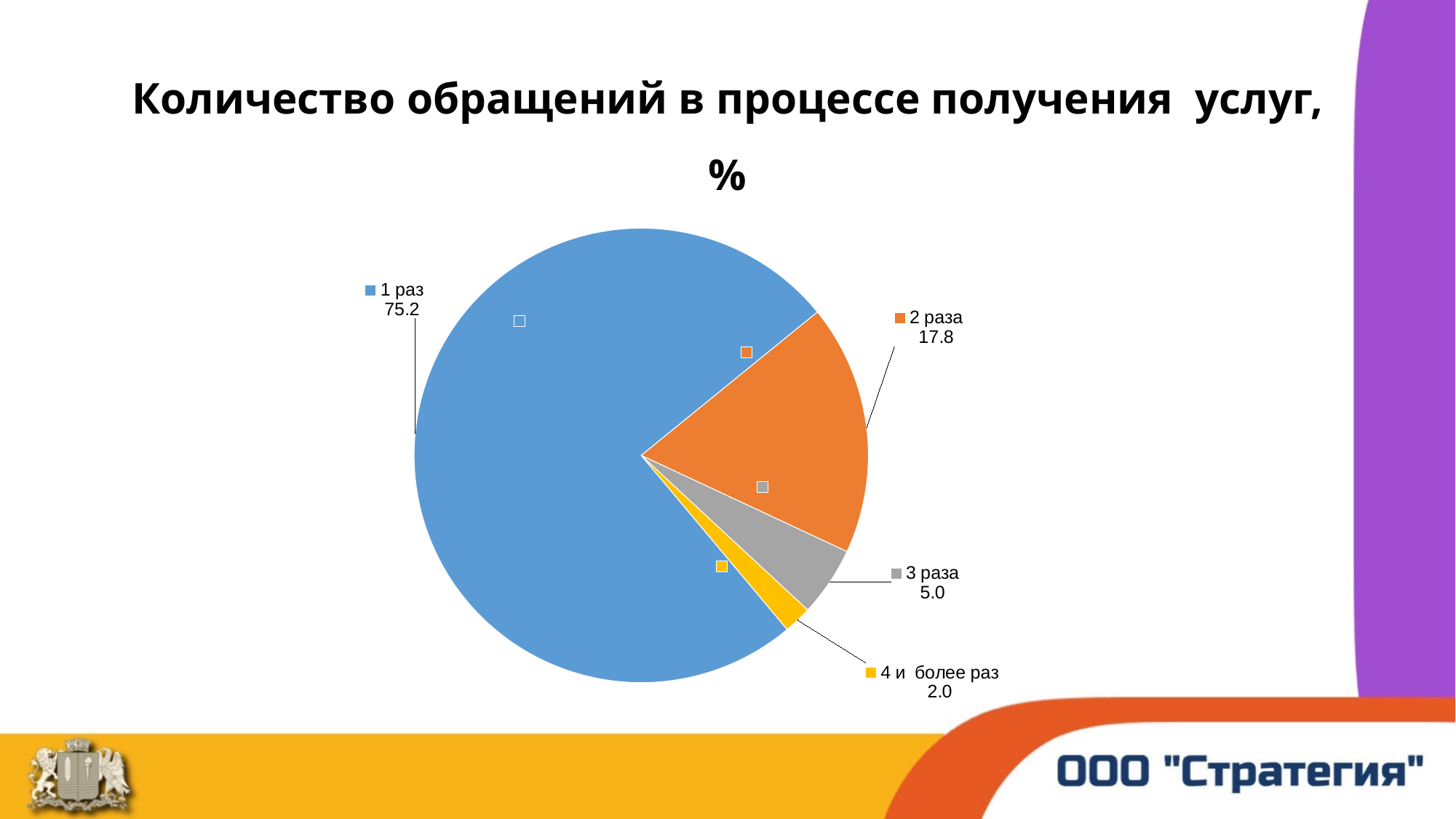
What is the difference between the values for "1 раз" and "2 раза"? 57.4 What is the value for "2 раза"? 17.8 What kind of chart is shown on the slide? pie chart What is the value for "1 раз"? 75.2 Which category has the smallest share of the pie? 4 и более раз What colour is the slice for "2 раза"? orange Which is larger, the value for "3 раза" or the value for "4 и более раз"? 3 раза What is the value for "4 и более раз"? 2.0 How many slices does the pie chart have? 4 Which category has the largest share of the pie? 1 раз What is the title of the chart? Количество обращений в процессе получения услуг, % What is the value for "3 раза"? 5.0